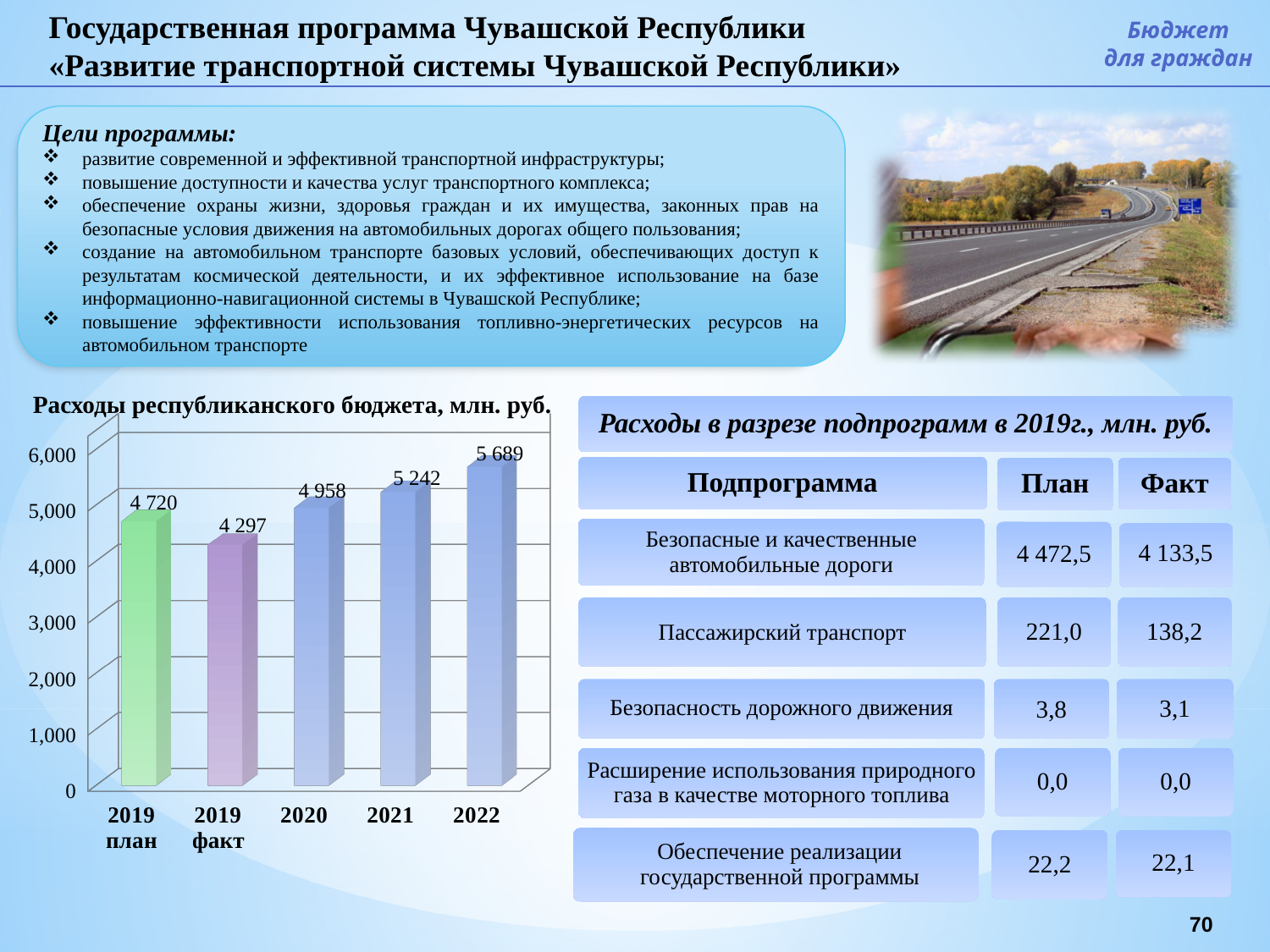
What type of chart is used to show 'Расходы республиканского бюджета, млн. руб.'? bar chart What is the value for 2022 in the chart? 5 689 Which category has the lowest value in the chart? 2019 факт Is the value for 2021 greater or less than 5,000? greater What is the value for 2019 план in the chart 'Расходы республиканского бюджета, млн. руб.'? 4 720 Which is larger, the value for 2020 or the value for 2019 план? 2020 How many bars are shown in the chart? 5 What is the difference between the 2019 план and 2019 факт values? 423 What is the value for 2021 in the chart? 5 242 What is the difference between the 2022 and 2020 values? 731 What is the value for 2019 факт in the chart? 4 297 Which category has the highest value in the chart? 2022